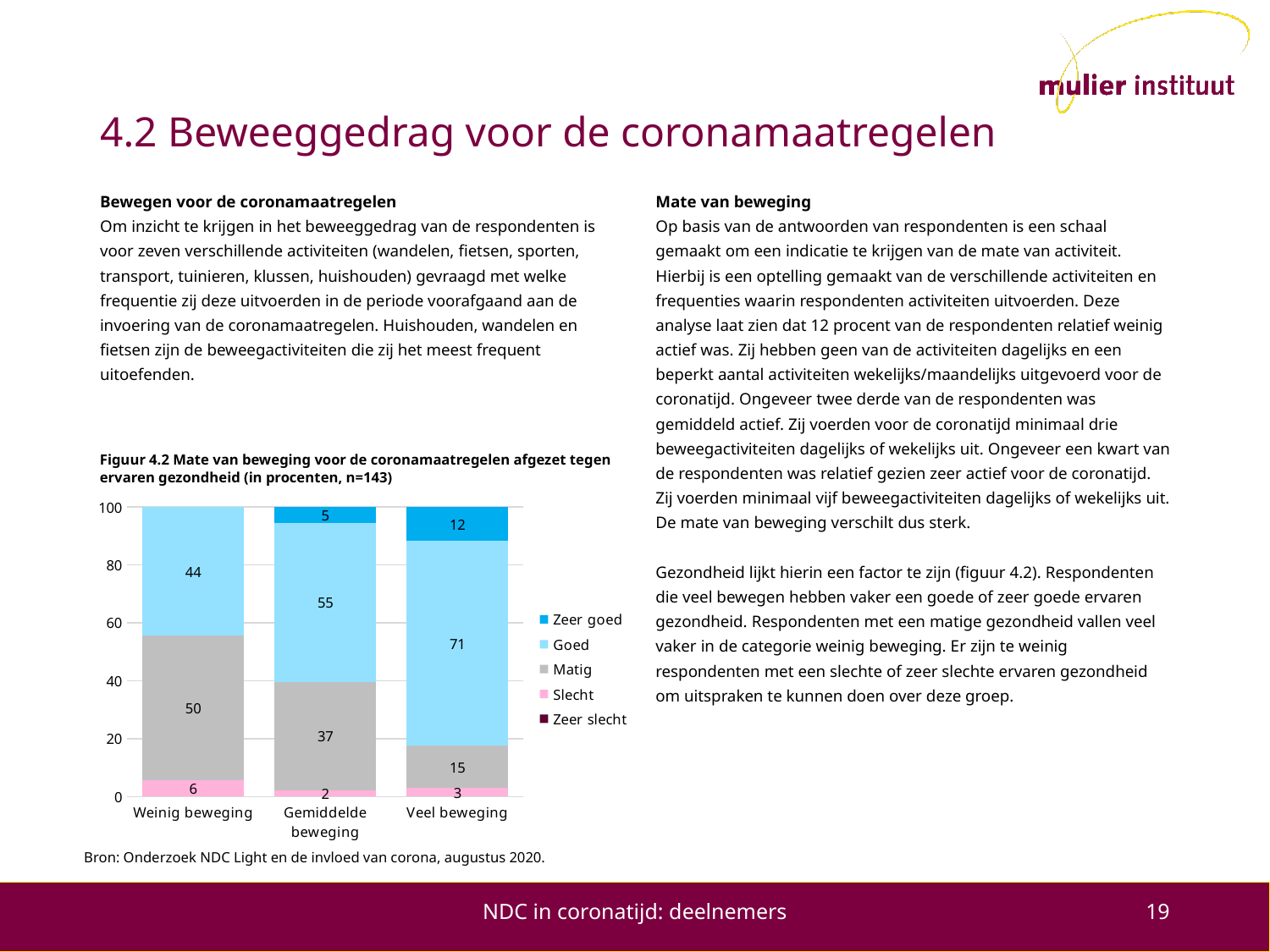
How many categories are shown on the x axis of Figuur 4.2? 3 Which is larger: the 'Matig' value for 'Gemiddelde beweging' or the 'Matig' value for 'Veel beweging'? Gemiddelde beweging What is the value for 'Goed' in the 'Veel beweging' bar? 71 What is the sum of the labelled segments in the 'Veel beweging' bar? 101 Which category has the lowest value for 'Goed'? Weinig beweging What kind of chart is shown in Figuur 4.2? Stacked bar chart What is the value for 'Matig' in the 'Weinig beweging' bar? 50 How many series does the legend of Figuur 4.2 list? 5 What is the value for 'Zeer goed' in the 'Gemiddelde beweging' bar? 5 What is the difference between the 'Goed' values for 'Veel beweging' and 'Gemiddelde beweging'? 16 Which category has the highest value for 'Matig'? Weinig beweging What is the value for 'Slecht' in the 'Veel beweging' bar? 3